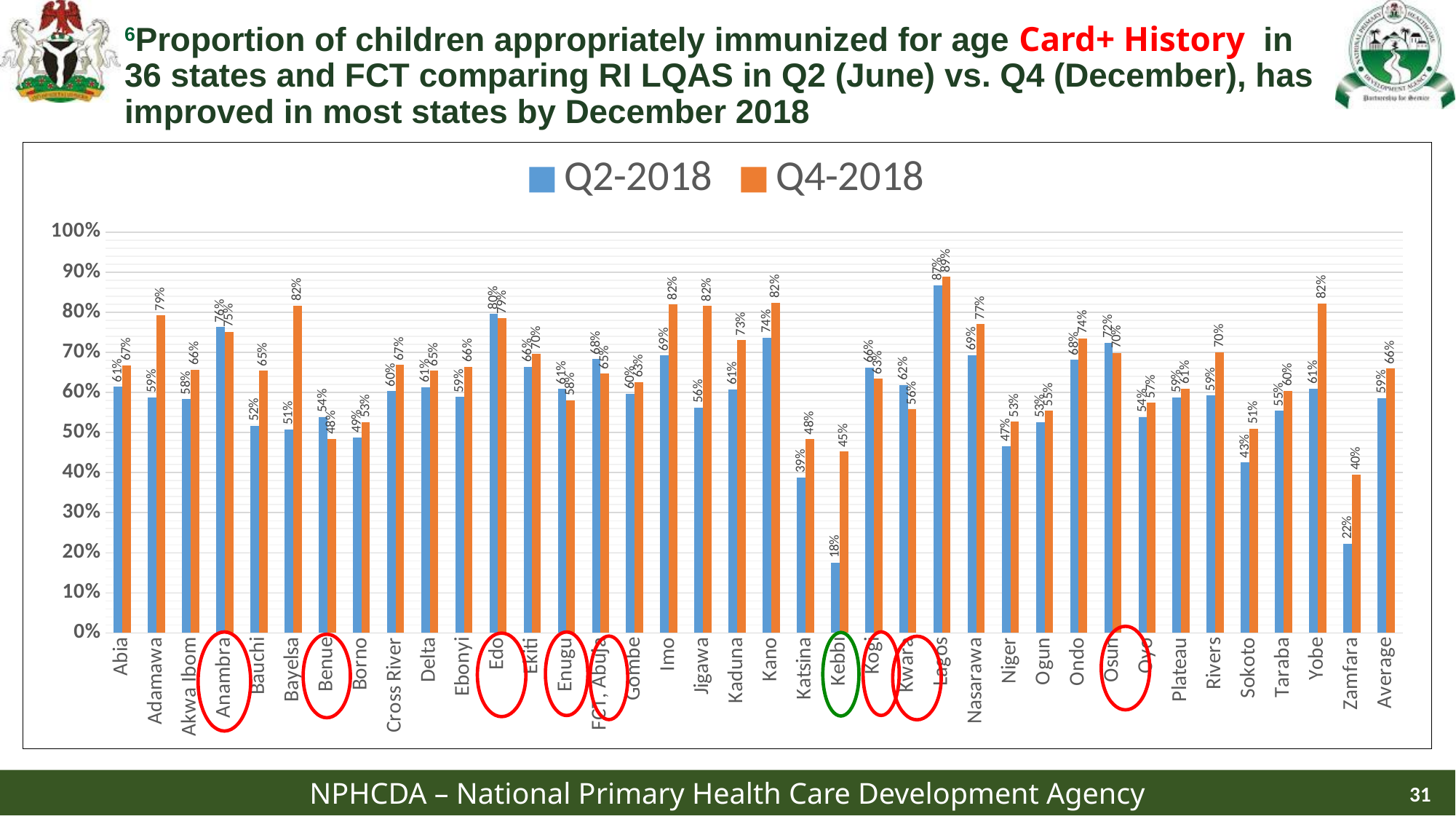
What is the Q4-2018 value for Kebbi? 45% Which state has the lowest Q2-2018 value? Kebbi What is the difference between the Q4-2018 and Q2-2018 values for Zamfara? 18% What is the Q4-2018 value for Adamawa? 79% Is the Q2-2018 value for Katsina greater or less than 50%? less What is the Average Q4-2018 value shown at the right end of the chart? 66% Which state has the highest Q4-2018 value? Lagos Which is larger for Benue, the Q2-2018 value or the Q4-2018 value? Q2-2018 Which state's label is circled in green on the x axis? Kebbi What kind of chart is shown on the slide? Bar chart What is the Q2-2018 value for Bayelsa? 51% How many series does the legend list? 2